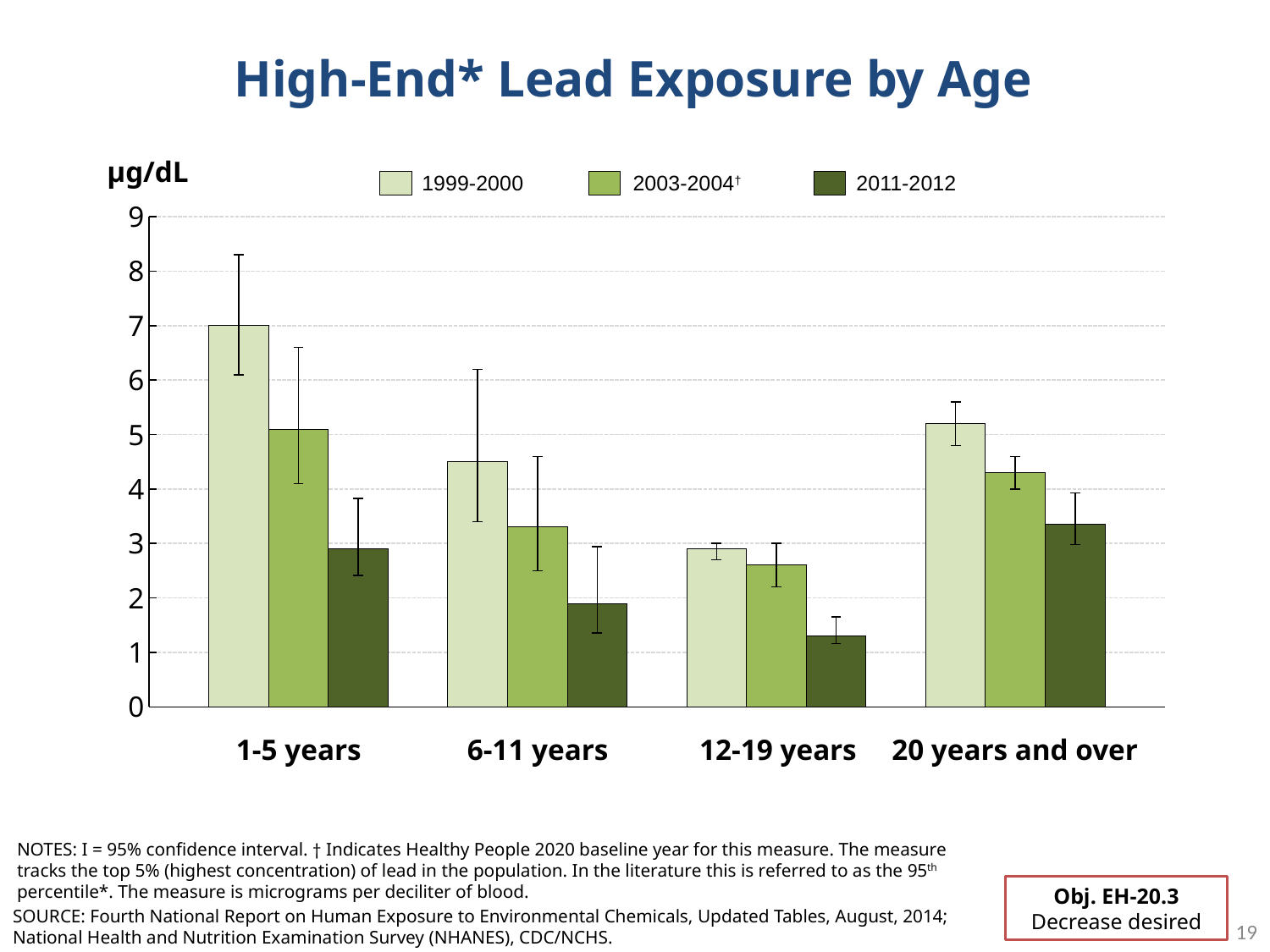
Is the 2003-2004 value for 20 years and over greater or less than 4? greater Which age group has the highest 1999-2000 value? 1-5 years Which age group has the lowest 2011-2012 value? 12-19 years Is the 1999-2000 value for 1-5 years greater or less than 6? greater What is the title of the chart? High-End* Lead Exposure by Age How many series does the legend list? 3 Is the 2011-2012 value for 12-19 years greater or less than 2? less What unit is shown on the y axis? µg/dL How many age groups are shown on the x axis? 4 Within the 1-5 years group, do the values rise or fall from 1999-2000 to 2011-2012? fall Which is larger: the 1999-2000 value for 6-11 years or the 1999-2000 value for 20 years and over? 20 years and over What kind of chart is shown on the slide? bar chart